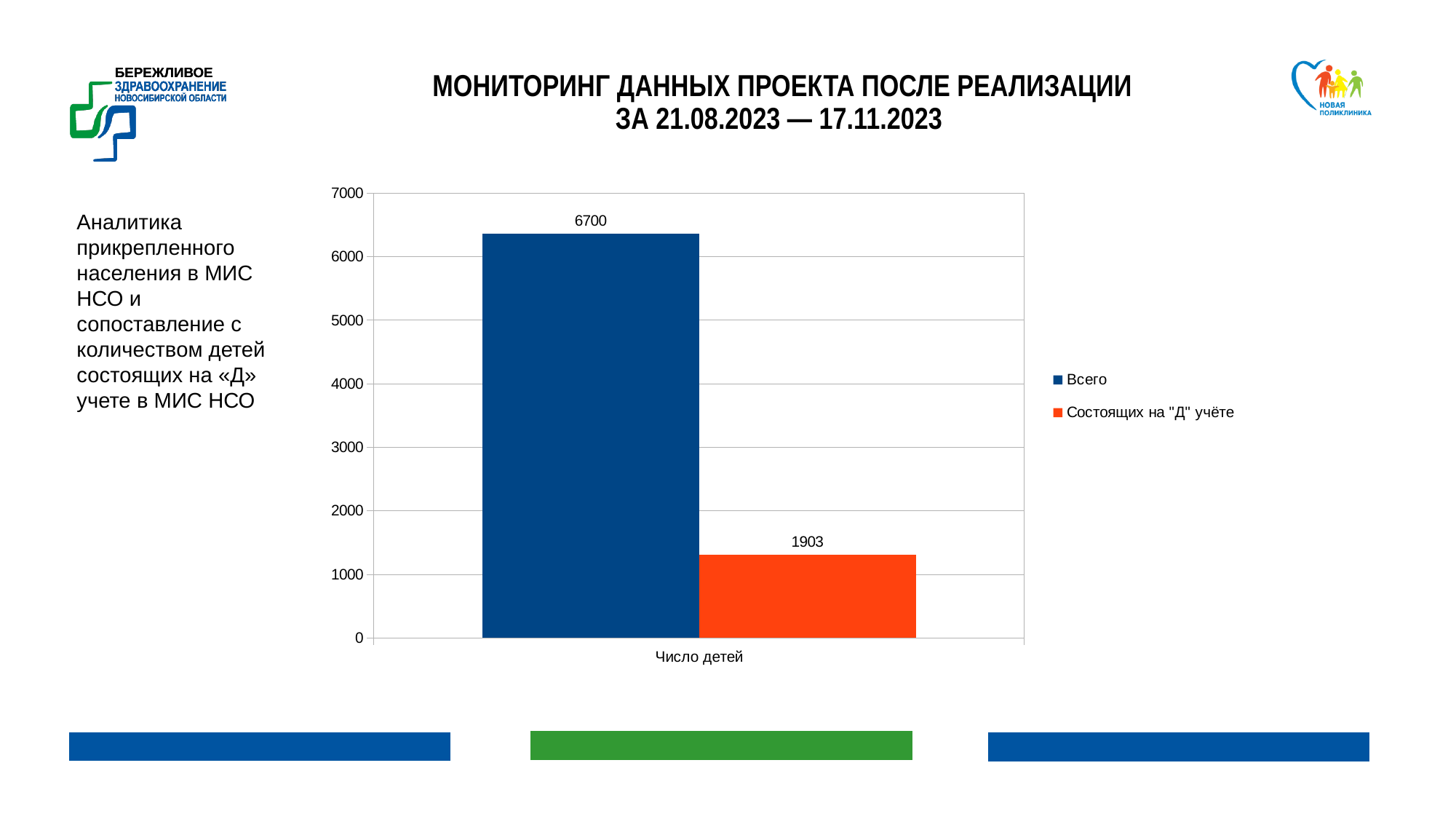
Which series has the higher value in the chart? Всего Is the bar for "Всего" greater or less than 5000 on the axis? greater What is the difference between the value for "Всего" and the value for "Состоящих на "Д" учёте"? 4797 What kind of chart is shown on the slide? bar chart What is the value for the series "Всего" in the chart? 6700 What is the label of the category on the x axis of the chart? Число детей How many categories are shown on the x axis of the chart? 1 Is the value for "Всего" larger or smaller than the value for "Состоящих на "Д" учёте"? larger Which series has the lower value in the chart? Состоящих на "Д" учёте How many series does the legend list? 2 What is the value for the series "Состоящих на "Д" учёте" in the chart? 1903 Is the bar for "Состоящих на "Д" учёте" greater or less than 2000 on the axis? less